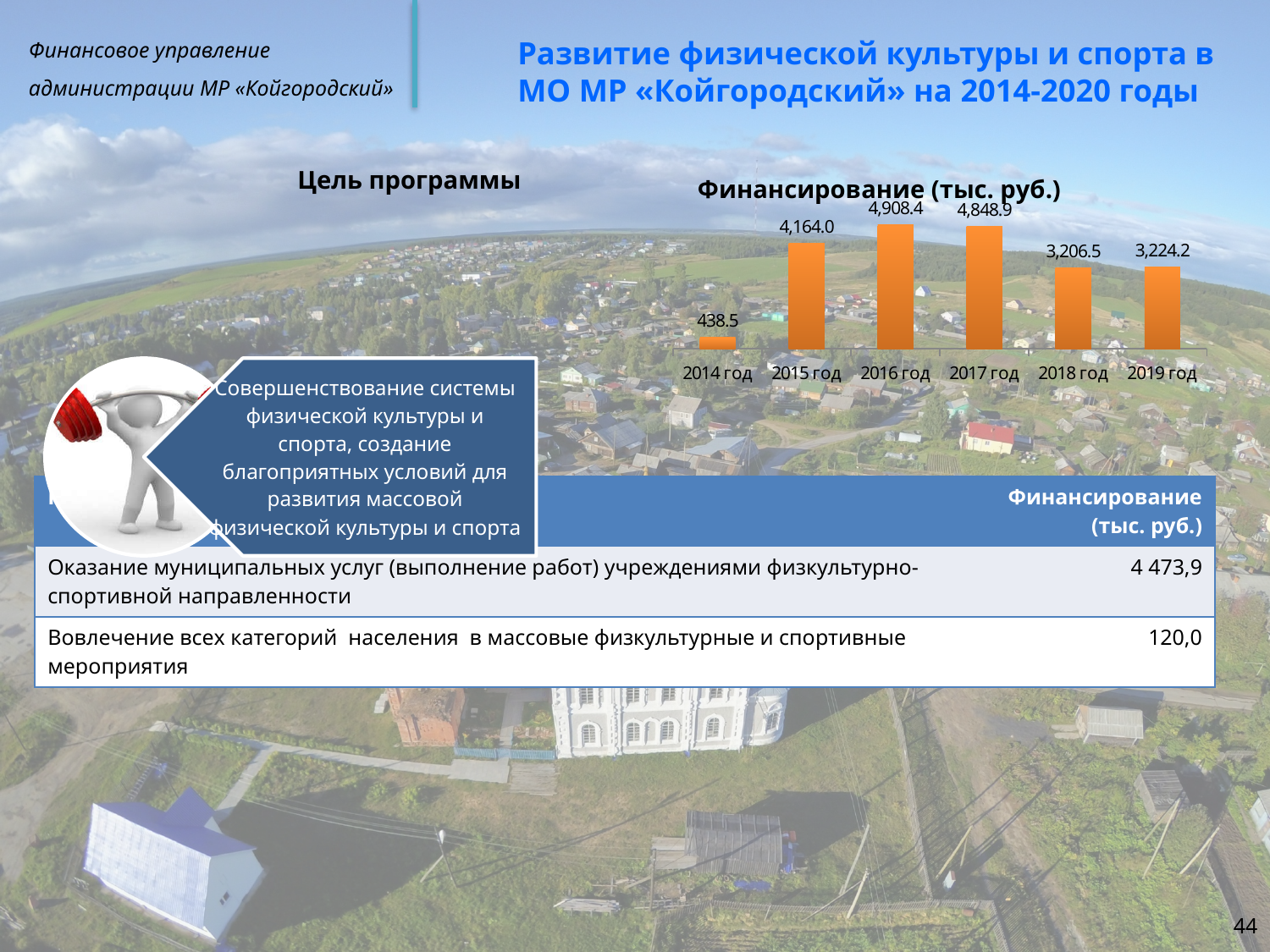
What is the title of the chart on the slide? Финансирование (тыс. руб.) What is the value for 2016 год in the Финансирование (тыс. руб.) chart? 4,908.4 How many years are shown in the Финансирование (тыс. руб.) chart? 6 Which is larger in the Финансирование (тыс. руб.) chart, the value for 2018 год or 2019 год? 2019 год What is the difference between the values for 2015 год and 2014 год in the Финансирование (тыс. руб.) chart? 3,725.5 Do the values in the Финансирование (тыс. руб.) chart rise or fall from 2014 год to 2016 год? Rise Which year has the highest value in the Финансирование (тыс. руб.) chart? 2016 год What is the value for 2014 год in the Финансирование (тыс. руб.) chart? 438.5 What is the value for 2018 год in the Финансирование (тыс. руб.) chart? 3,206.5 What kind of chart is the Финансирование (тыс. руб.) chart? Bar chart Which year has the lowest value in the Финансирование (тыс. руб.) chart? 2014 год What is the difference between the values for 2016 год and 2017 год in the Финансирование (тыс. руб.) chart? 59.5